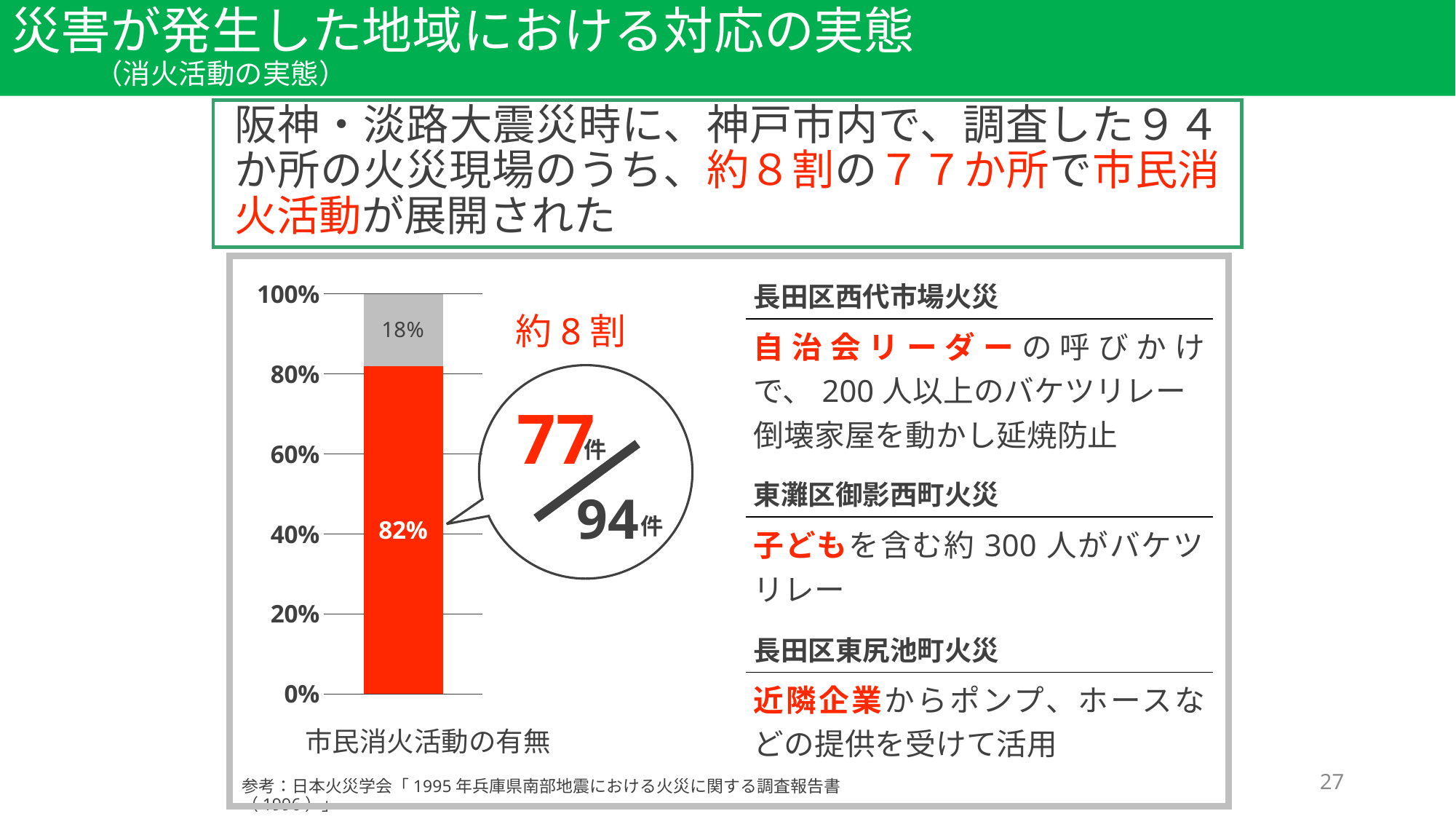
What is the highest tick value shown on the vertical axis? 100% What percentage does the gray segment at the top of the bar show? 18% Is the value of the gray segment greater or less than 20%? less What is the total of the two segments of the stacked bar? 100% How many bars are plotted in the chart? 1 What is the difference between the red segment (82%) and the gray segment (18%)? 64% What percentage does the red segment of the bar show? 82% What is the category label shown below the bar? 市民消火活動の有無 Is the value of the red segment greater or less than 80%? greater What kind of chart is shown on the slide? bar chart Which segment of the bar is larger, the red one or the gray one? the red one According to the callout next to the bar, how many of the 94 fire sites had citizen firefighting activity? 77件